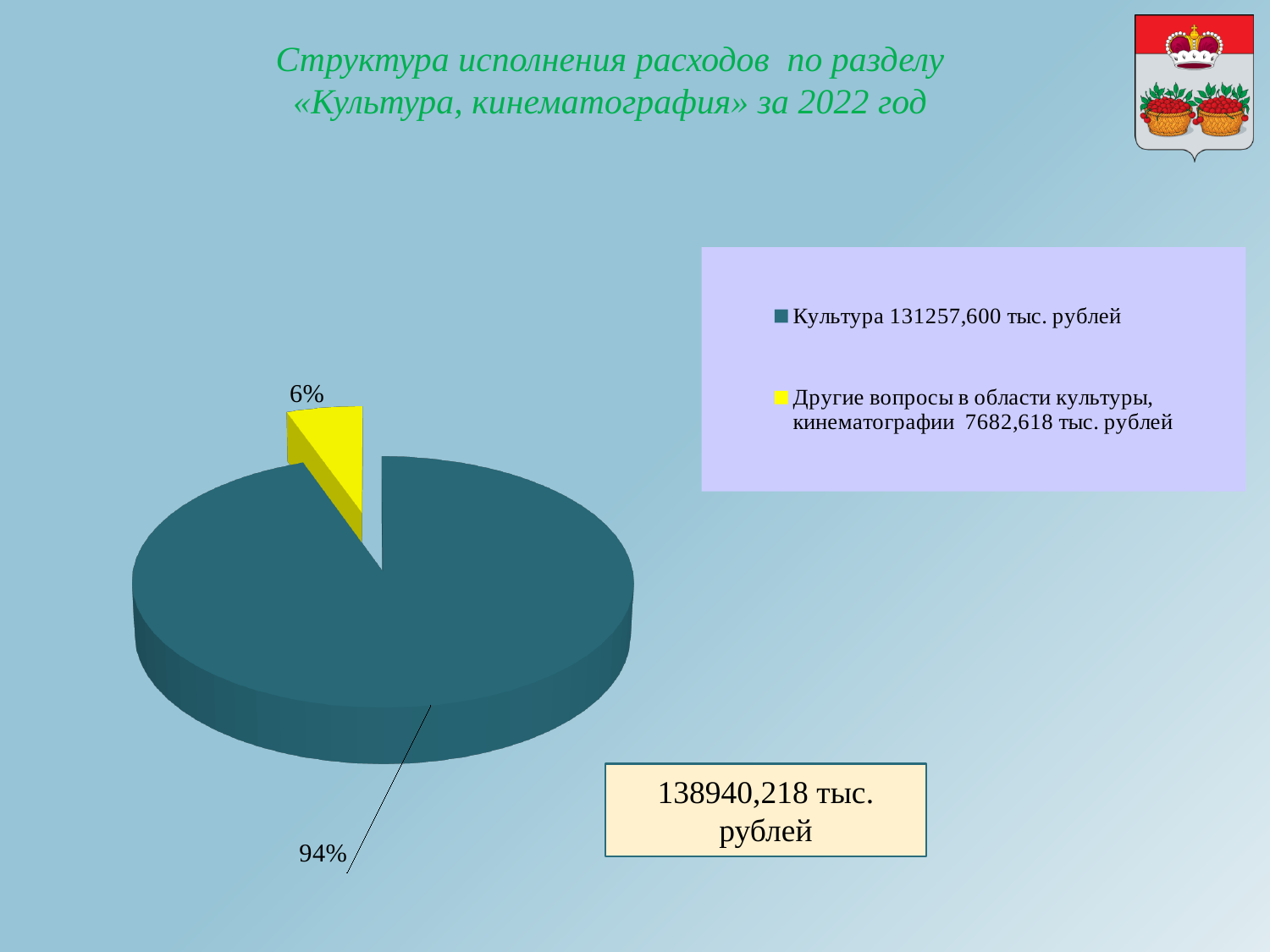
Which slice of the pie is the smallest? Другие вопросы в области культуры, кинематографии According to the legend, what is the amount for "Другие вопросы в области культуры, кинематографии"? 7682,618 тыс. рублей What total amount is shown in the box below the legend? 138940,218 тыс. рублей Which is larger: the share for "Культура" or the share for "Другие вопросы в области культуры, кинематографии"? Культура What is the difference in percentage points between the "Культура" slice and the "Другие вопросы в области культуры, кинематографии" slice? 88 percentage points How many entries does the legend list? 2 Which slice of the pie is the largest? Культура How many slices does the pie chart have? 2 What kind of chart is shown on the slide? pie chart According to the legend, what is the amount for "Культура"? 131257,600 тыс. рублей What share of the pie does the "Культура" slice represent? 94% What share of the pie does the "Другие вопросы в области культуры, кинематографии" slice represent? 6%